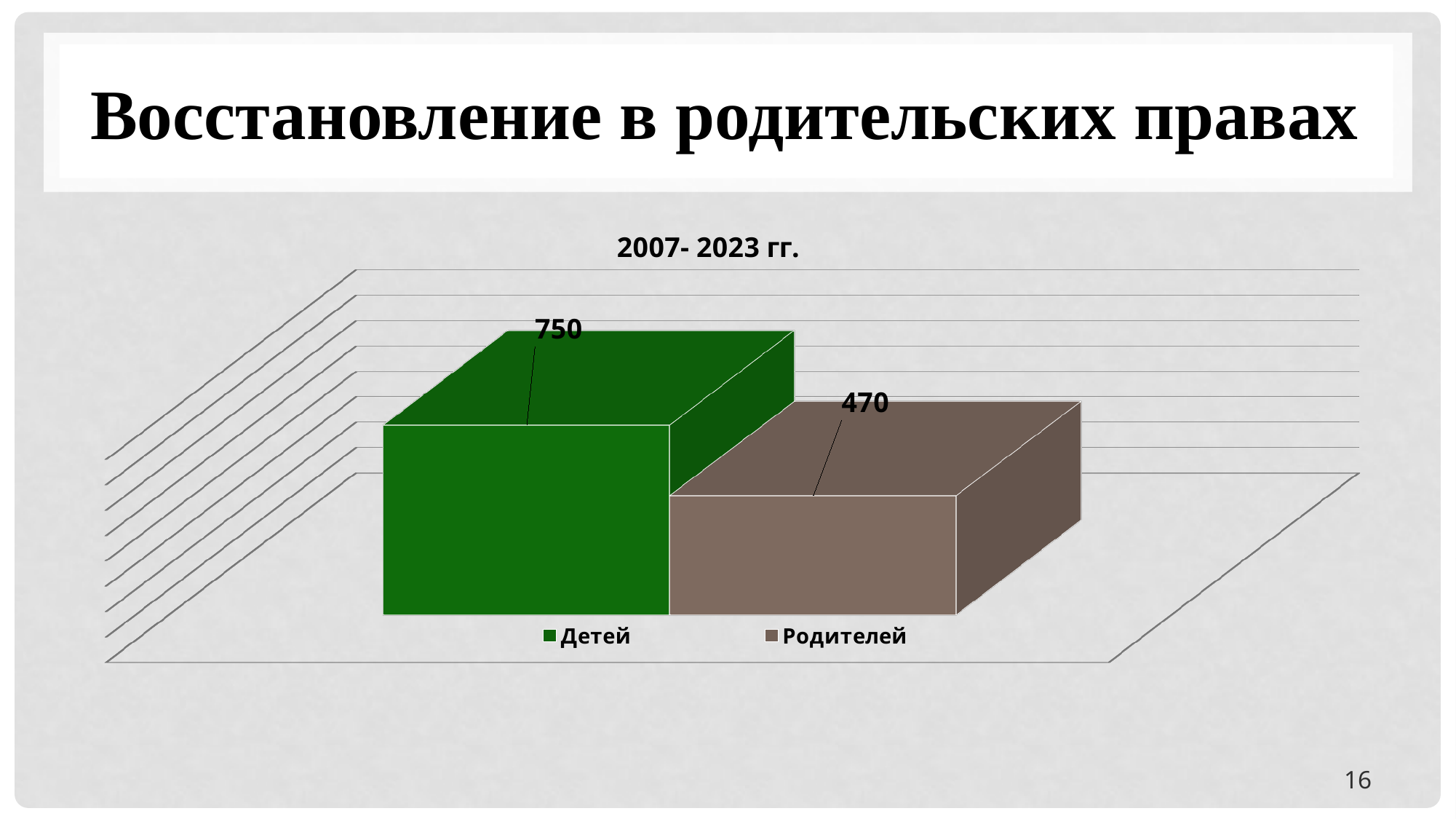
Which is larger, the value for Детей or the value for Родителей? Детей What is the title of the chart? 2007- 2023 гг. Which series has the lowest value? Родителей How many bars are plotted in the chart? 2 What is the difference between the values for Детей and Родителей? 280 What is the value for Детей? 750 What is the value for Родителей? 470 What kind of chart is shown on the slide? Bar chart What colour is the bar for Детей? Green How many series does the legend list? 2 Which series has the highest value? Детей What is the total of the two plotted values? 1220